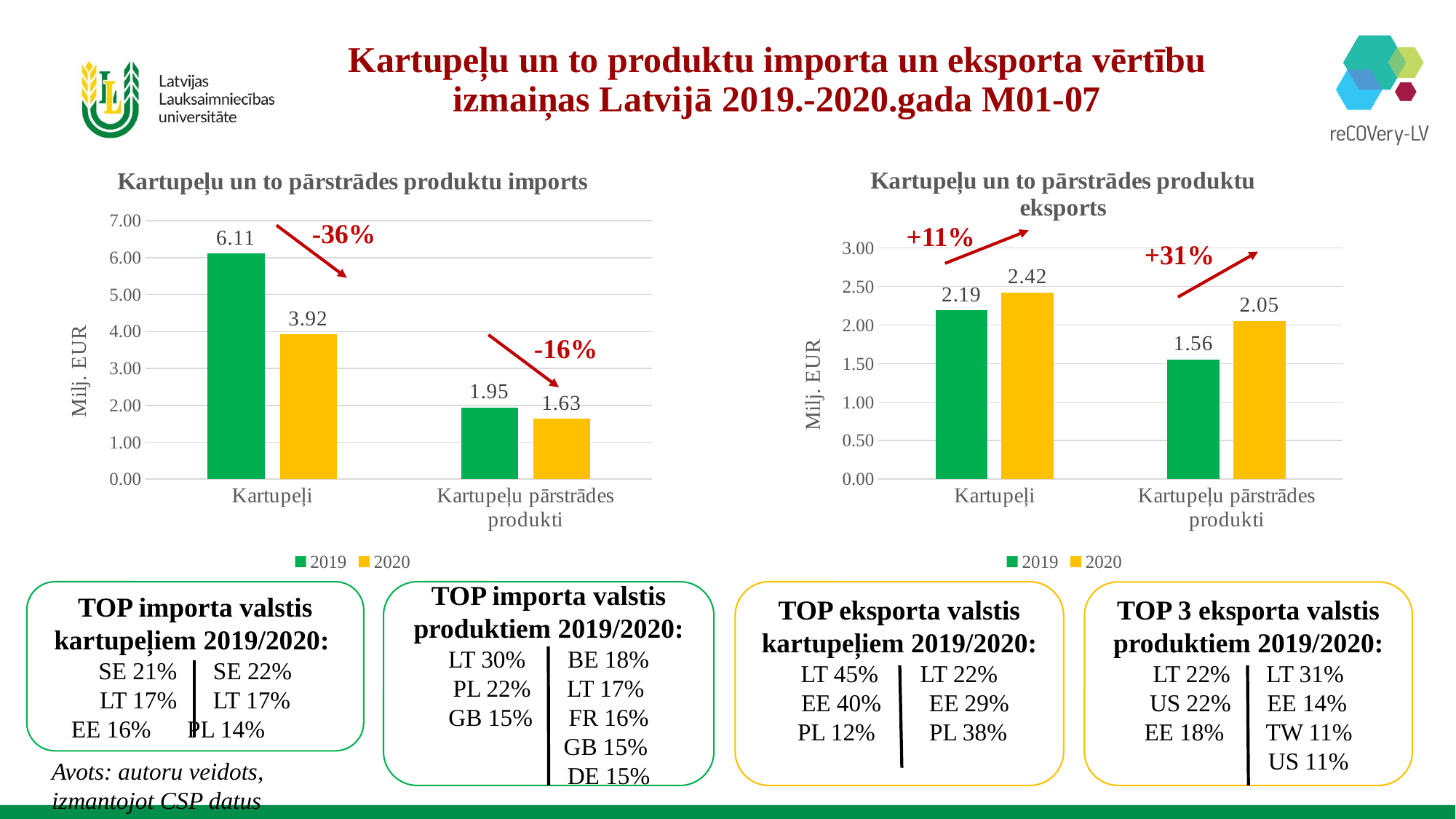
What kind of chart is the chart titled "Kartupeļu un to pārstrādes produktu eksports"? bar chart In the chart titled "Kartupeļu un to pārstrādes produktu eksports", what is the 2019 value for Kartupeļu pārstrādes produkti? 1.56 In the chart titled "Kartupeļu un to pārstrādes produktu imports", what percentage change is annotated for Kartupeļi? -36% How many series does the legend of the chart titled "Kartupeļu un to pārstrādes produktu imports" list? 2 In the chart titled "Kartupeļu un to pārstrādes produktu imports", what is the 2019 value for Kartupeļi? 6.11 In the chart titled "Kartupeļu un to pārstrādes produktu eksports", which bar is the lowest? Kartupeļu pārstrādes produkti, 2019 In the chart titled "Kartupeļu un to pārstrādes produktu eksports", what is the difference between the 2020 and 2019 values for Kartupeļu pārstrādes produkti? 0.49 In the chart titled "Kartupeļu un to pārstrādes produktu imports", which bar is the highest? Kartupeļi, 2019 In the chart titled "Kartupeļu un to pārstrādes produktu imports", what is the difference between the 2019 and 2020 values for Kartupeļi? 2.19 In the chart titled "Kartupeļu un to pārstrādes produktu eksports", is the 2019 value for Kartupeļi larger or smaller than the 2020 value? smaller In the chart titled "Kartupeļu un to pārstrādes produktu imports", what is the 2020 value for Kartupeļu pārstrādes produkti? 1.63 In the chart titled "Kartupeļu un to pārstrādes produktu eksports", what is the 2020 value for Kartupeļi? 2.42